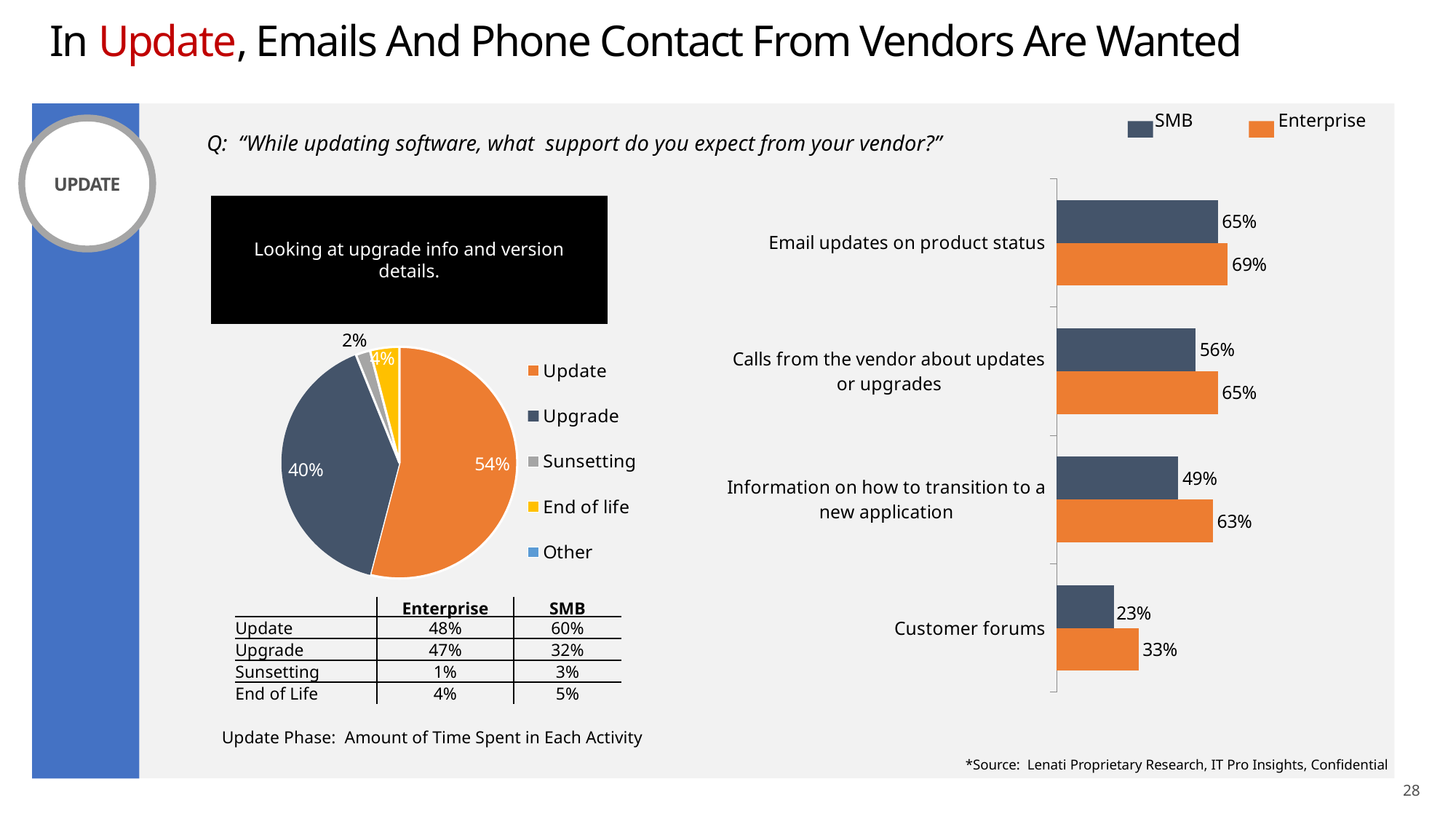
In the pie chart on the left, which slice is the largest? Update How many categories are shown in the bar chart on the right? 4 In the bar chart on the right, what is the SMB value for "Customer forums"? 23% In the bar chart on the right, what is the Enterprise value for "Email updates on product status"? 69% How many entries does the legend of the pie chart on the left list? 5 In the bar chart on the right, for "Calls from the vendor about updates or upgrades", which is larger: the SMB value or the Enterprise value? Enterprise In the bar chart on the right, what is the difference between the Enterprise and SMB values for "Information on how to transition to a new application"? 14% What kind of chart is the chart on the right side of the slide? Bar chart How many series does the legend of the bar chart on the right list? 2 In the bar chart on the right, which category has the highest Enterprise value? Email updates on product status In the bar chart on the right, which category has the lowest SMB value? Customer forums In the pie chart on the left, what share does the "Update" slice have? 54%